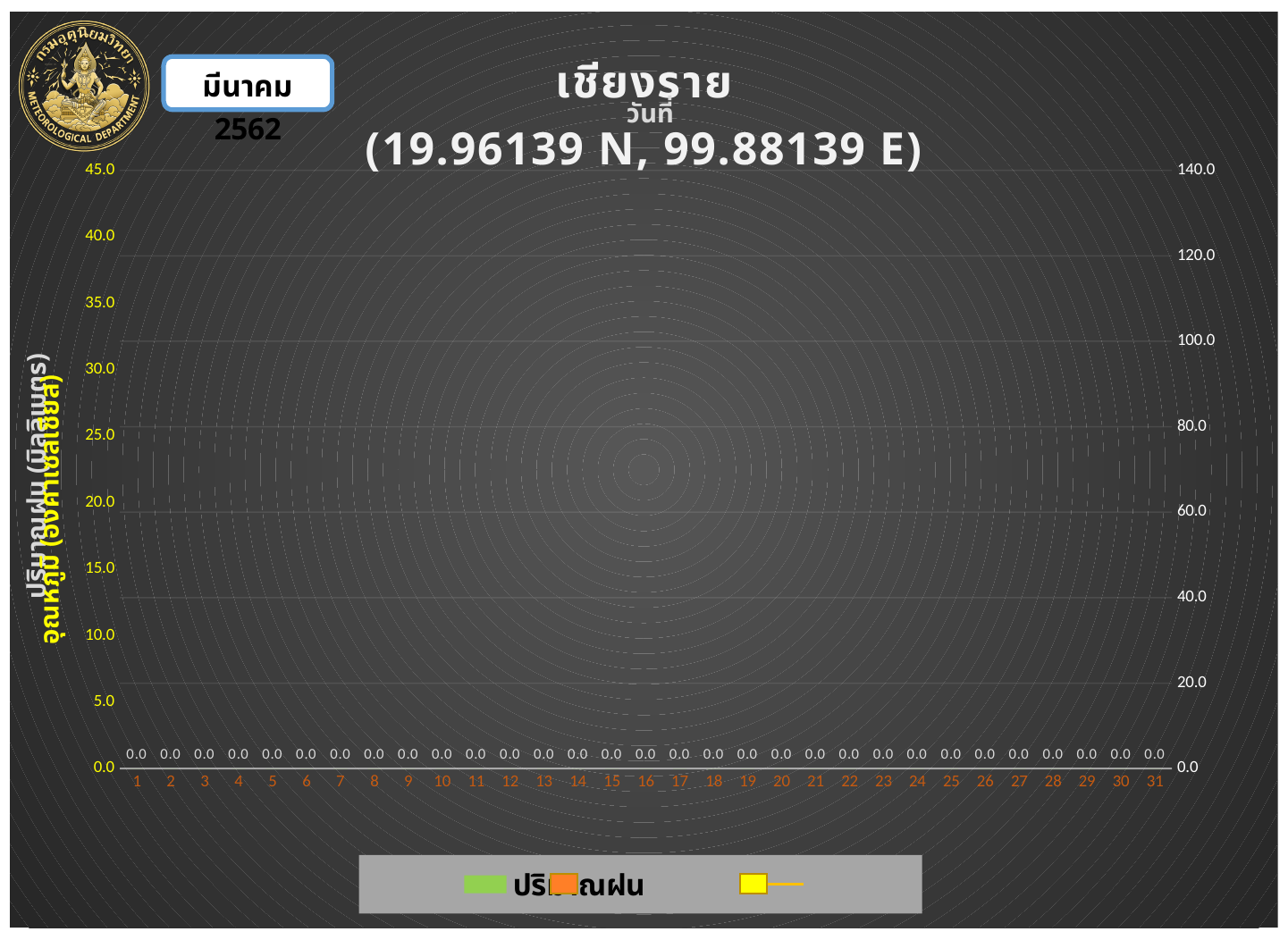
What is the highest tick value shown on the left vertical axis? 45.0 What is the difference between the labelled values for day 10 and day 20? 0.0 What is the data label shown for day 15 on the chart? 0.0 What is the data label shown for day 1 on the chart? 0.0 Do the labelled values rise, fall, or stay flat from day 1 to day 31? stay flat What is the data label shown for day 31 on the chart? 0.0 How many days (categories) are shown along the x axis of the chart? 31 Is the labelled value for day 5 greater or less than 5.0 on the left axis? less What is the highest tick value shown on the right vertical axis? 140.0 What are the coordinates given in the chart title? (19.96139 N, 99.88139 E)